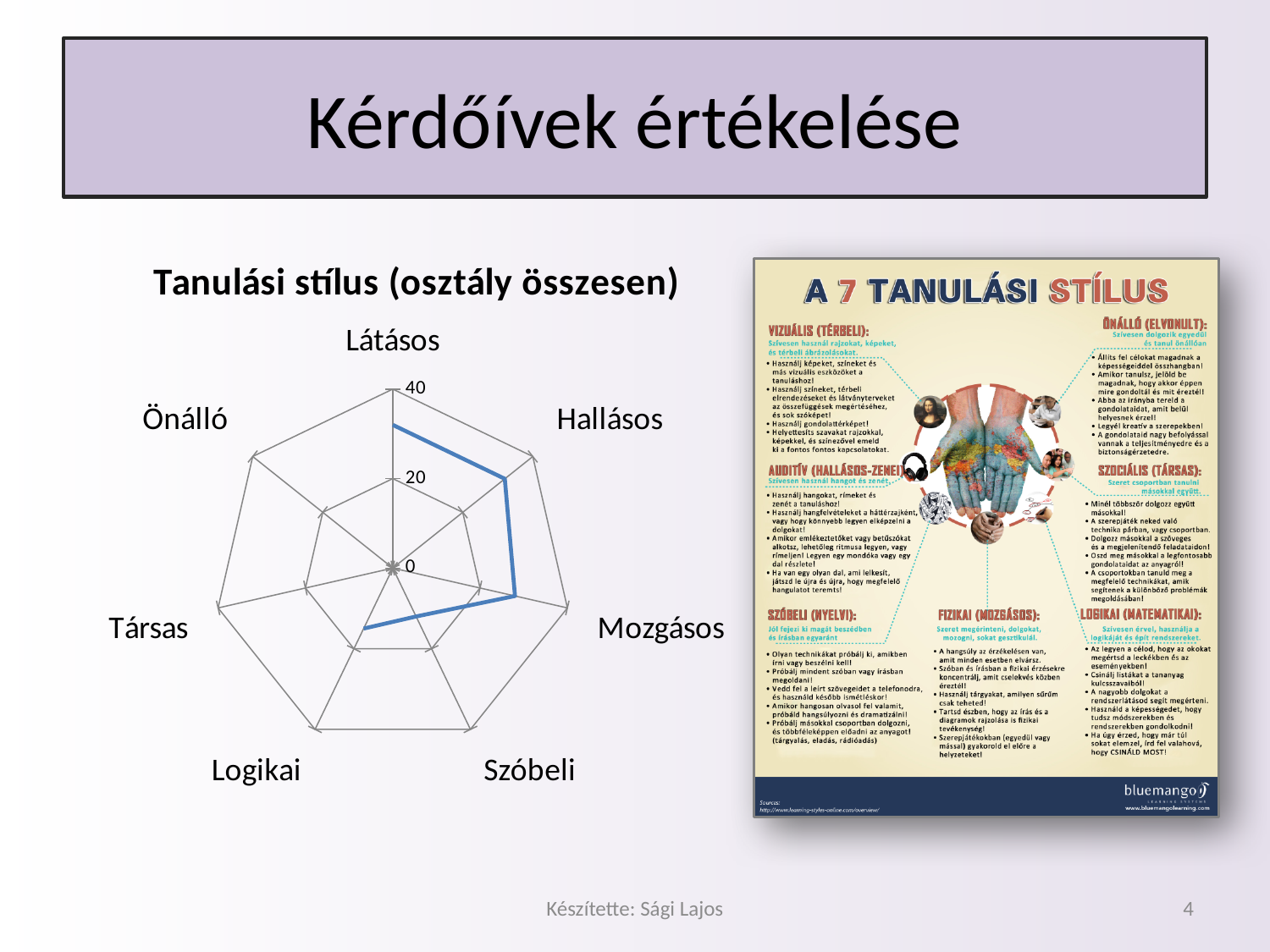
Is the value for Mozgásos greater or less than 20? greater Is the value for Látásos greater or less than 40? less What kind of chart is shown on the left of the slide? Radar chart What is the highest value shown on the radar chart's axis scale? 40 How many categories (axes) does the radar chart have? 7 Which category is plotted at the top of the radar chart? Látásos Is the value for Látásos greater or less than 20? greater What is the title of the chart on the left of the slide? Tanulási stílus (osztály összesen)